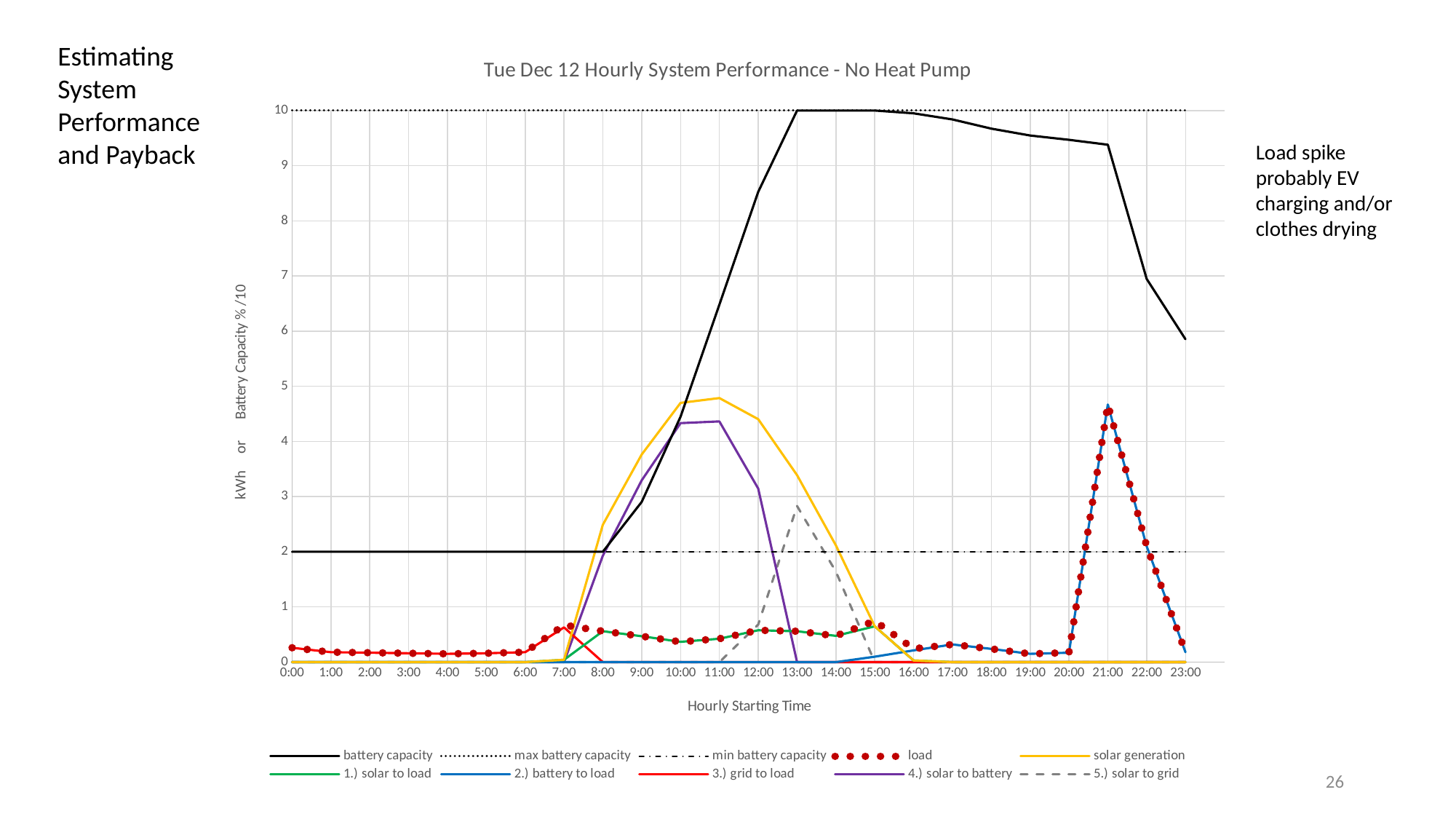
Does the battery capacity rise or fall between 8:00 and 13:00? rise What value does the min battery capacity line sit at? 2 What is the title of the chart? Tue Dec 12 Hourly System Performance - No Heat Pump What kind of chart is shown on the slide? line chart How many hourly points are plotted along the x axis? 24 Is the load value at 21:00 greater or less than 4? greater At which hour is the load highest? 21:00 What is the battery capacity value at 3:00? 2 Is the solar generation value at 11:00 greater or less than 4? greater At which hour does the solar to grid series reach its peak? 13:00 What value does the max battery capacity line sit at? 10 How many series does the legend list? 10